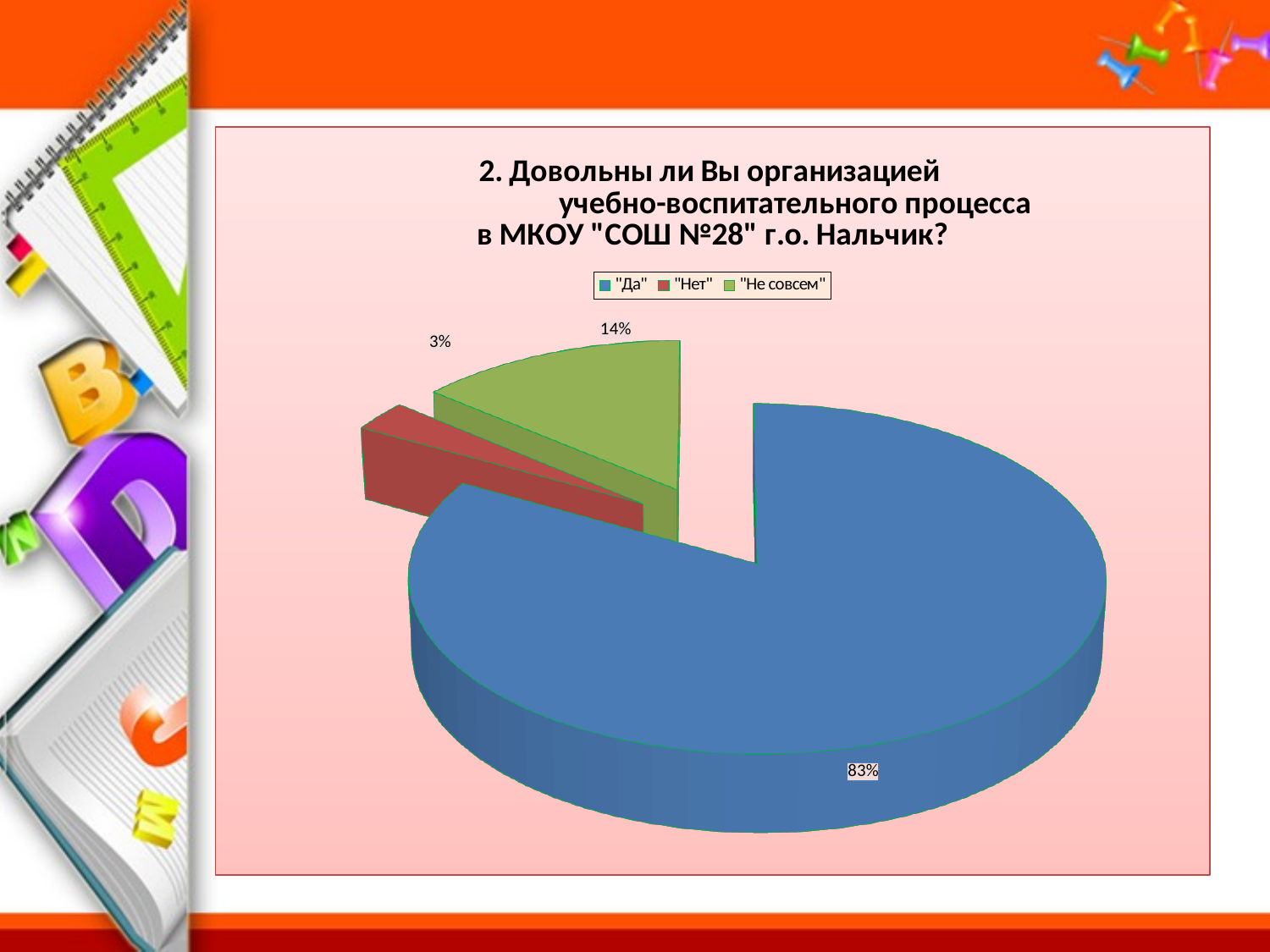
Which answer has the smallest share of the pie? "Нет" Which answer has the largest share of the pie? "Да" What percentage of respondents answered "Да"? 83% What percentage of respondents answered "Не совсем"? 14% What percentage of respondents answered "Нет"? 3% What kind of chart is shown on the slide? Pie chart What colour is the slice for "Не совсем"? Green Which is larger, the share for "Нет" or the share for "Не совсем"? "Не совсем" What is the difference in percentage points between "Да" and "Не совсем"? 69 How many entries does the legend list? 3 How many slices does the pie chart have? 3 What is the difference in percentage points between "Не совсем" and "Нет"? 11